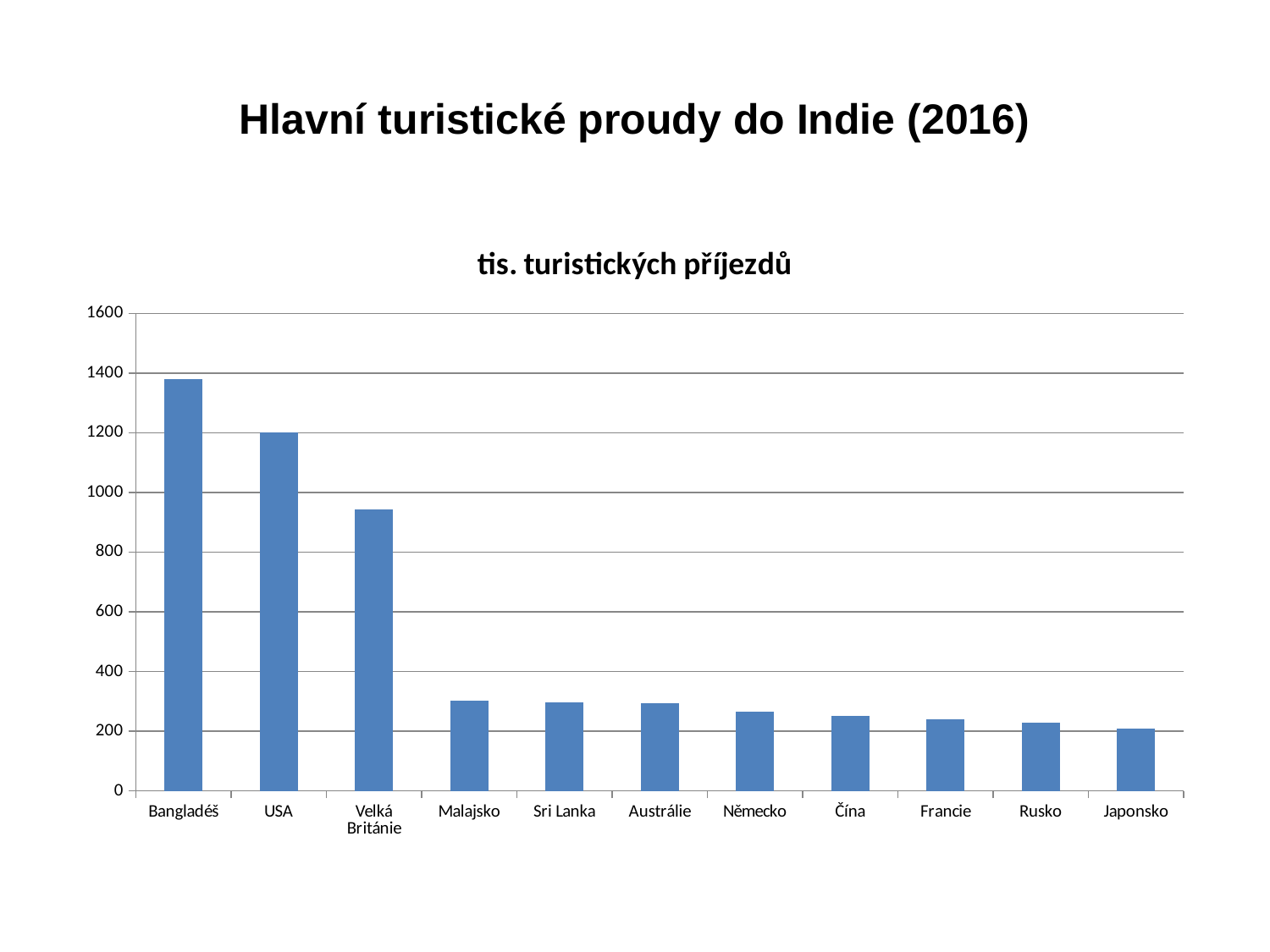
What is the title of the chart? tis. turistických příjezdů Is the value for USA greater or less than 1400? less What kind of chart is shown on the slide? bar chart Is the value for Bangladéš greater or less than 1200? greater Which has a larger value, Bangladéš or USA? Bangladéš Is the value for Velká Británie greater or less than 1000? less Which country has the lowest value in the chart? Japonsko Which has a larger value, Velká Británie or Malajsko? Velká Británie Which country has the highest value in the chart? Bangladéš Do the values rise or fall from left to right along the x axis? fall How many countries are shown on the x axis of the chart? 11